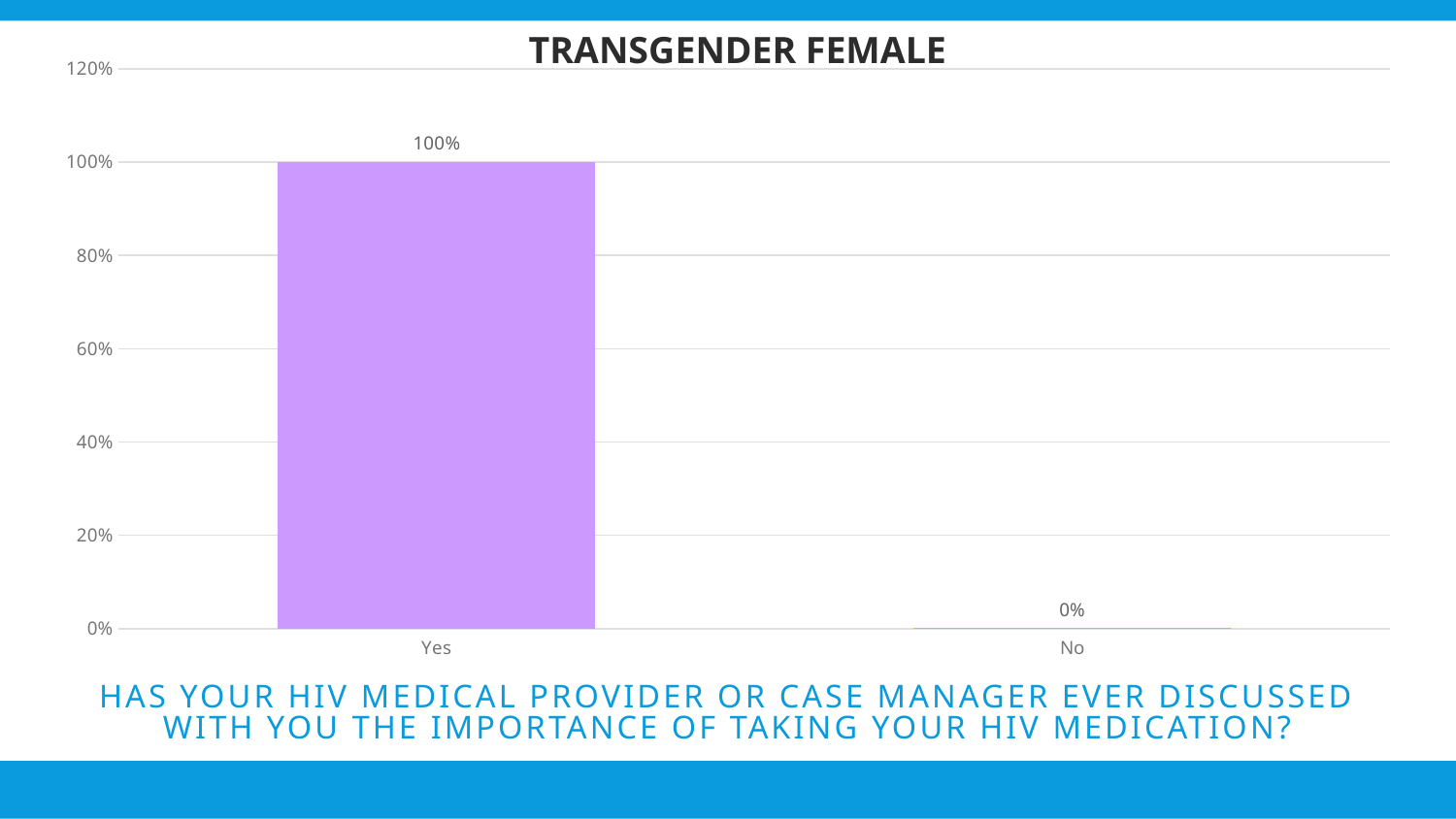
Is the value for Yes greater or less than 80%? greater Which category has the lowest value? No What is the value for No? 0% How many categories are shown on the x axis? 2 Which category has the highest value? Yes Do the values rise or fall from Yes to No? fall What is the value for Yes? 100% What is the difference between the values for Yes and No? 100% What is the highest value shown on the y axis? 120% What is the title of the chart? TRANSGENDER FEMALE What kind of chart is shown on the slide? bar chart Which is larger, the value for Yes or the value for No? Yes